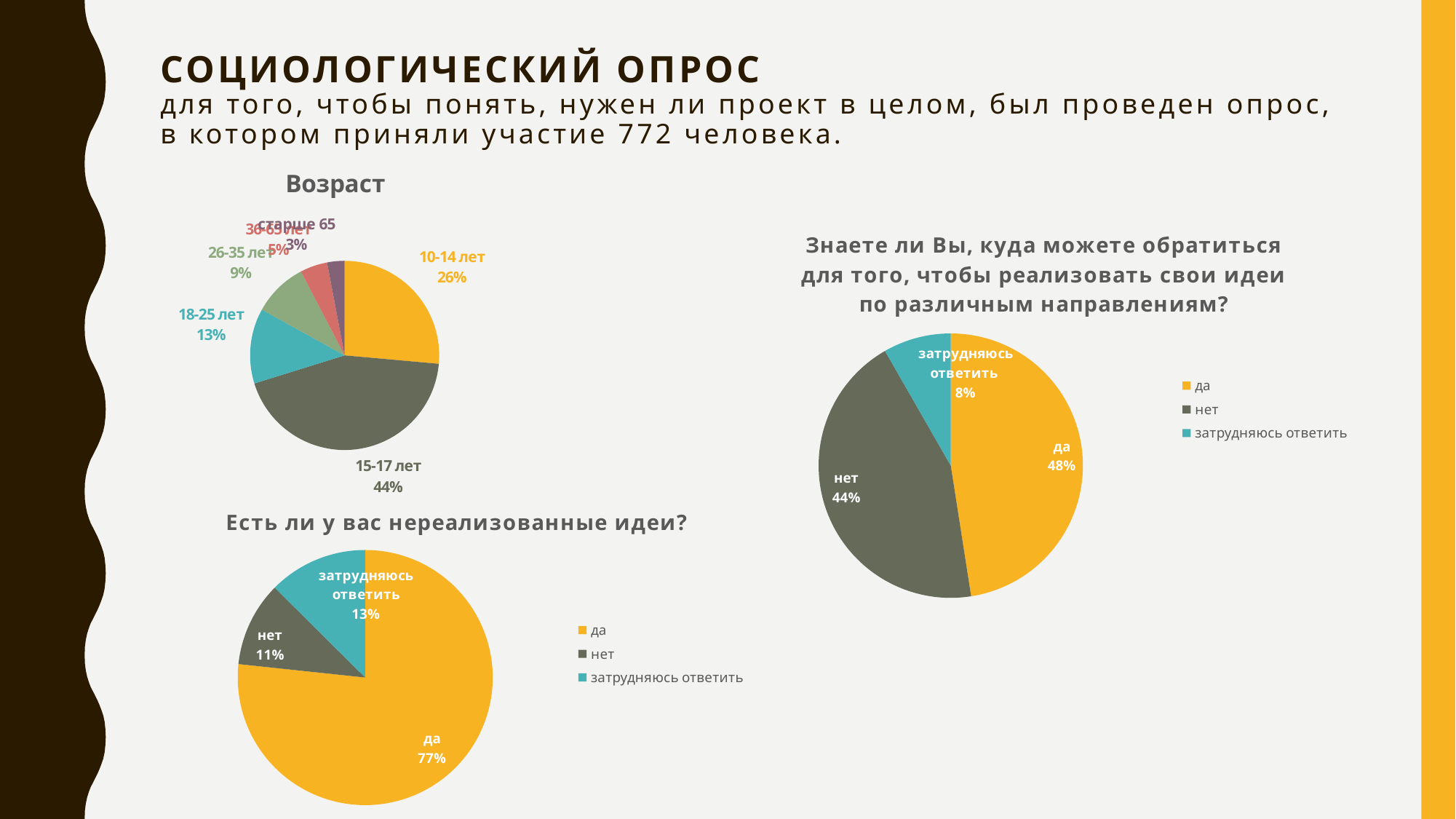
In the 'Есть ли у вас нереализованные идеи?' chart, what is the difference between 'да' and 'затрудняюсь ответить'? 64% In the 'Знаете ли Вы, куда можете обратиться...' chart, what share answered 'нет'? 44% In the 'Знаете ли Вы, куда можете обратиться...' chart, which is larger, 'да' or 'нет'? да In the 'Есть ли у вас нереализованные идеи?' chart, which answer has the smallest share? нет In the 'Возраст' chart, which age group has the largest share? 15-17 лет In the 'Возраст' chart, what is the difference between the shares of 18-25 лет and 26-35 лет? 4% In the 'Возраст' chart, how many age groups are shown? 6 In the 'Есть ли у вас нереализованные идеи?' chart, what share answered 'да'? 77% In the 'Возраст' chart, what share of respondents are aged 10-14 лет? 26% In the 'Знаете ли Вы, куда можете обратиться...' chart, how many entries does the legend list? 3 What type of chart is the 'Есть ли у вас нереализованные идеи?' chart? pie chart In the 'Возраст' chart, what share of respondents are aged 15-17 лет? 44%